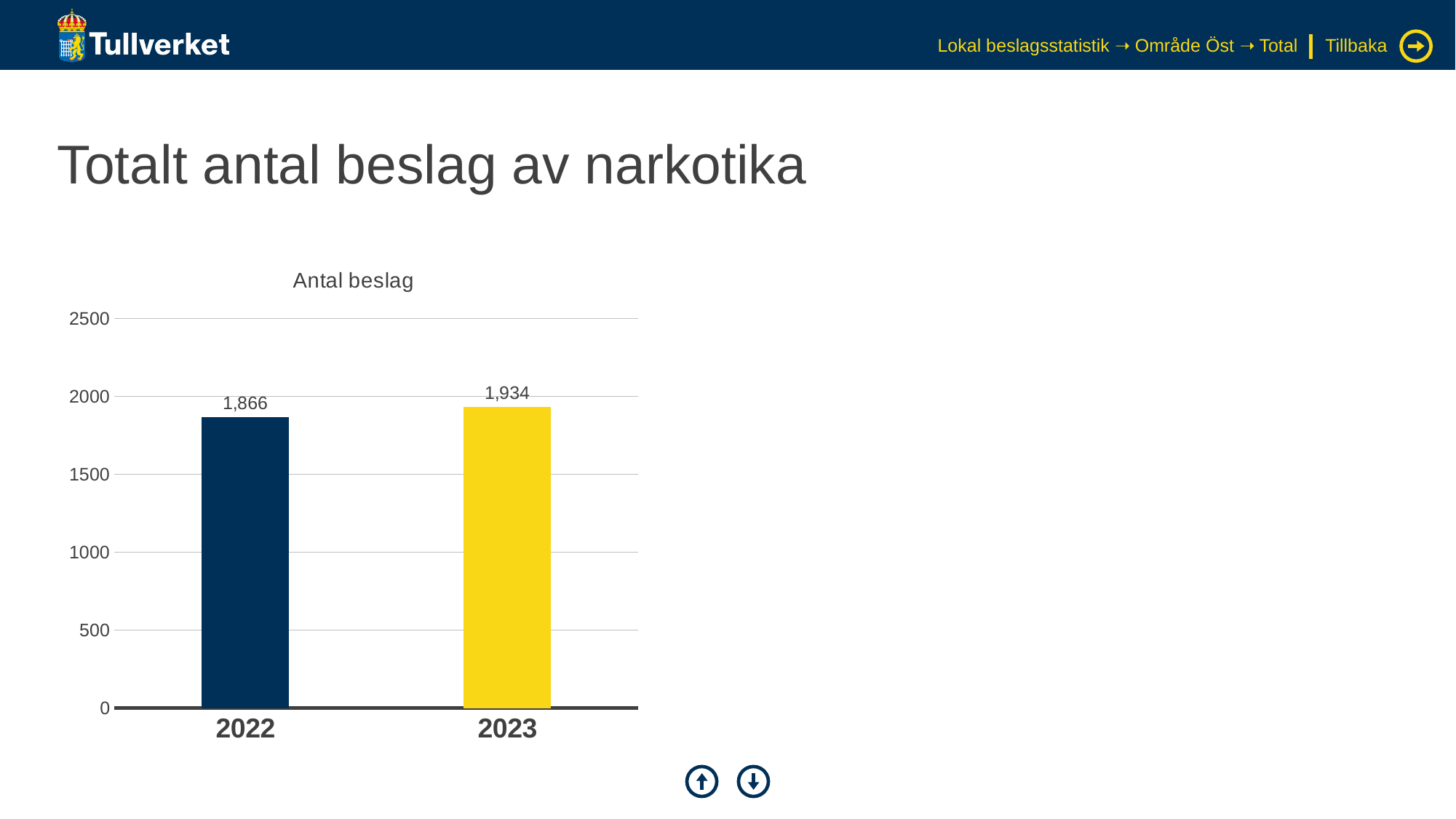
What is the value for 2023? 1,934 Which is larger, the value for 2022 or the value for 2023? 2023 Is the value for 2023 greater or less than 1500? greater How many years are shown on the x axis? 2 Is the value for 2022 greater or less than 2000? less Do the values rise or fall from 2022 to 2023? rise Which year has the highest value? 2023 Which year has the lowest value? 2022 What is the value for 2022? 1,866 What is the title of the chart? Antal beslag What is the difference between the values for 2023 and 2022? 68 What kind of chart is shown? bar chart